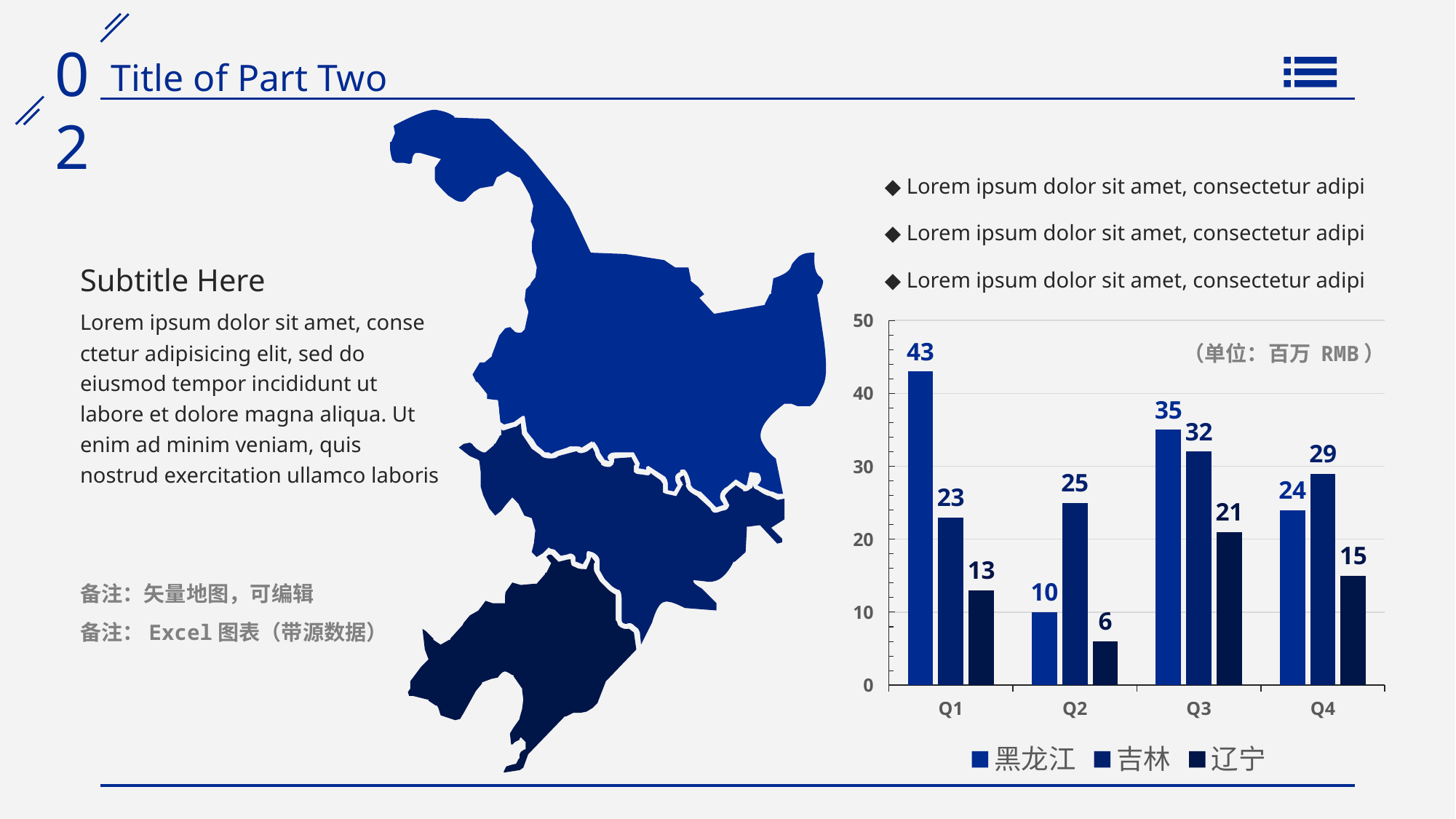
How many series does the legend list? 3 In which quarter does 黑龙江 have its lowest value? Q2 In which quarter does 吉林 have its highest value? Q3 What is the difference between 黑龙江 and 辽宁 in Q1? 30 Is the value for 辽宁 in Q3 greater or less than 20? greater What unit is stated in the chart's annotation? 百万 RMB What is the value for 辽宁 in Q2? 6 What is the value for 吉林 in Q4? 29 What kind of chart is shown on the slide? bar chart What is the value for 黑龙江 in Q1? 43 Which is larger in Q4, 黑龙江 or 吉林? 吉林 How many quarters are shown on the x axis? 4